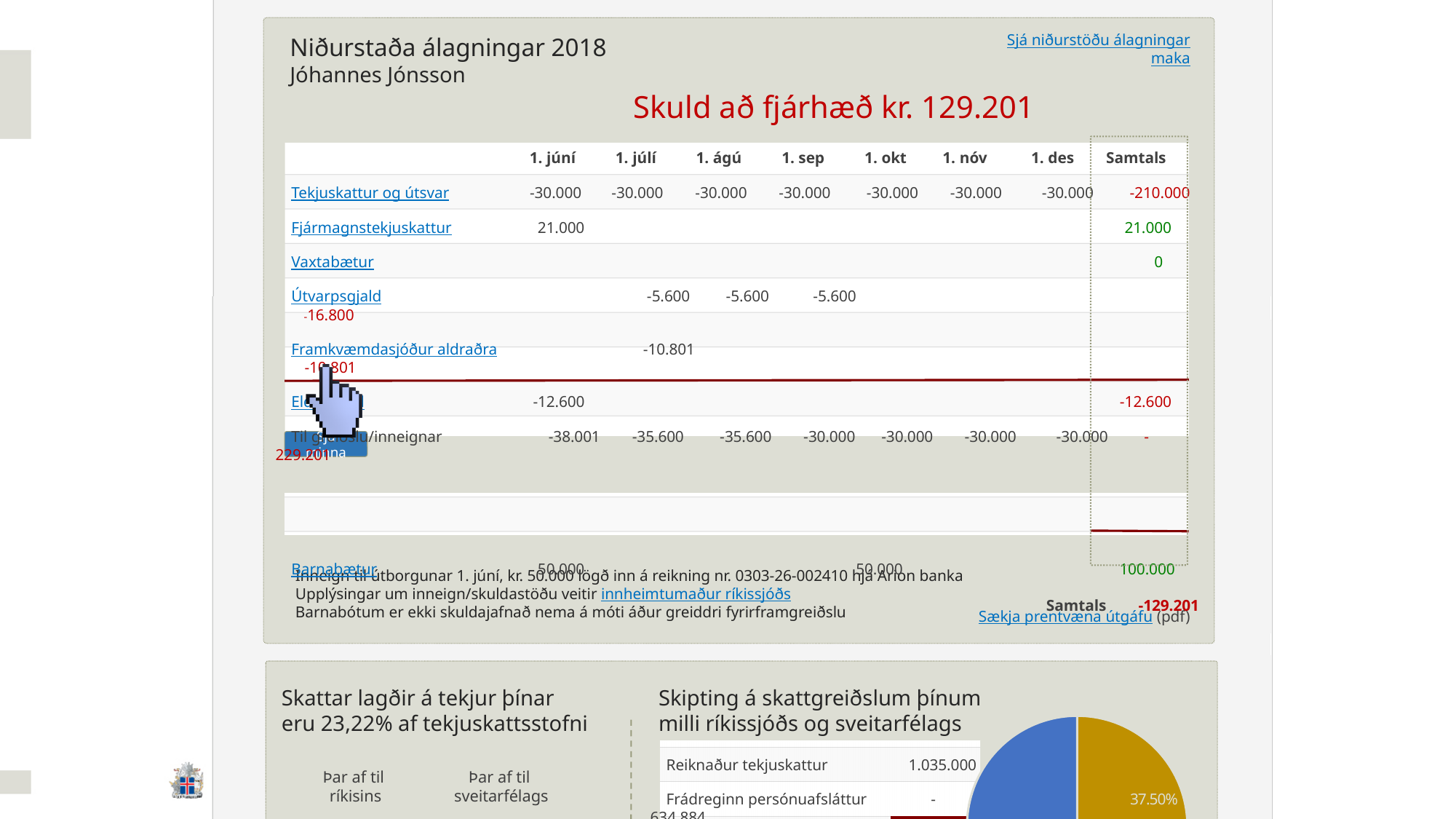
In the pie chart at the bottom right of the slide, what percentage is printed on the gold slice? 37.50% In the pie chart at the bottom right of the slide, is the share of the gold slice greater or less than 50%? less What is the title printed above the pie chart at the bottom right of the slide? Skipting á skattgreiðslum þínum milli ríkissjóðs og sveitarfélags What two colours are used for the slices of the pie chart at the bottom right of the slide? blue and gold In the pie chart at the bottom right of the slide, which slice is larger, the blue one or the gold one? blue What kind of chart is shown at the bottom right of the slide, under the title 'Skipting á skattgreiðslum þínum milli ríkissjóðs og sveitarfélags'? pie chart